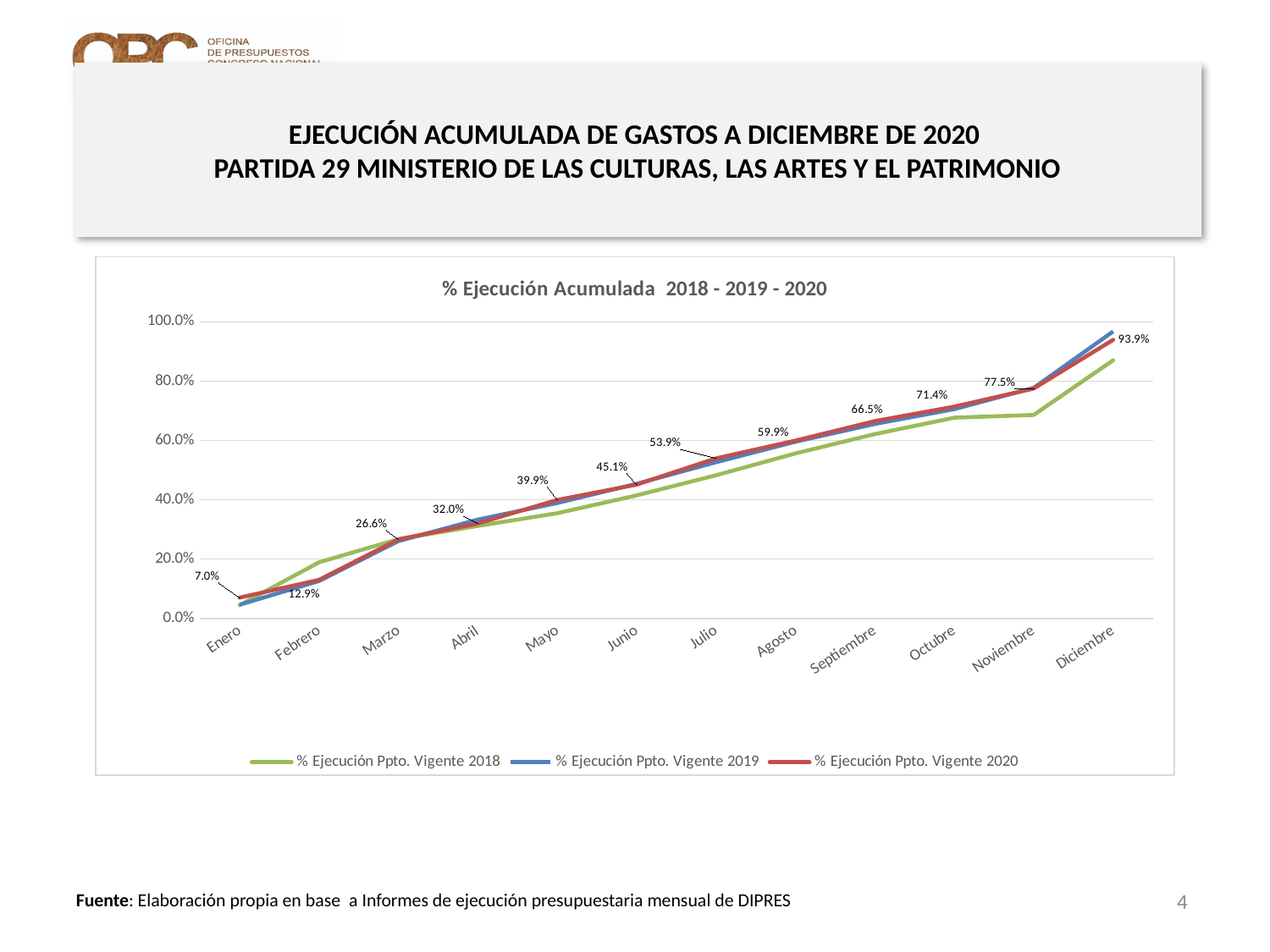
What is the value for % Ejecución Ppto. Vigente 2020 in Junio? 45.1% What is the difference between the 2020 values for Diciembre and Noviembre? 16.4% Which month has the lowest value for % Ejecución Ppto. Vigente 2020? Enero Do the values for % Ejecución Ppto. Vigente 2020 rise or fall from Enero to Diciembre? rise What is the value for % Ejecución Ppto. Vigente 2020 in Noviembre? 77.5% What is the value for % Ejecución Ppto. Vigente 2020 in Enero? 7.0% How many months are shown on the x axis? 12 What type of chart is shown on the slide? line chart How many series does the legend list? 3 What is the title of the chart? % Ejecución Acumulada 2018 - 2019 - 2020 Is the value for % Ejecución Ppto. Vigente 2018 in Diciembre greater or less than 80.0%? greater What is the value for % Ejecución Ppto. Vigente 2020 in Diciembre? 93.9%